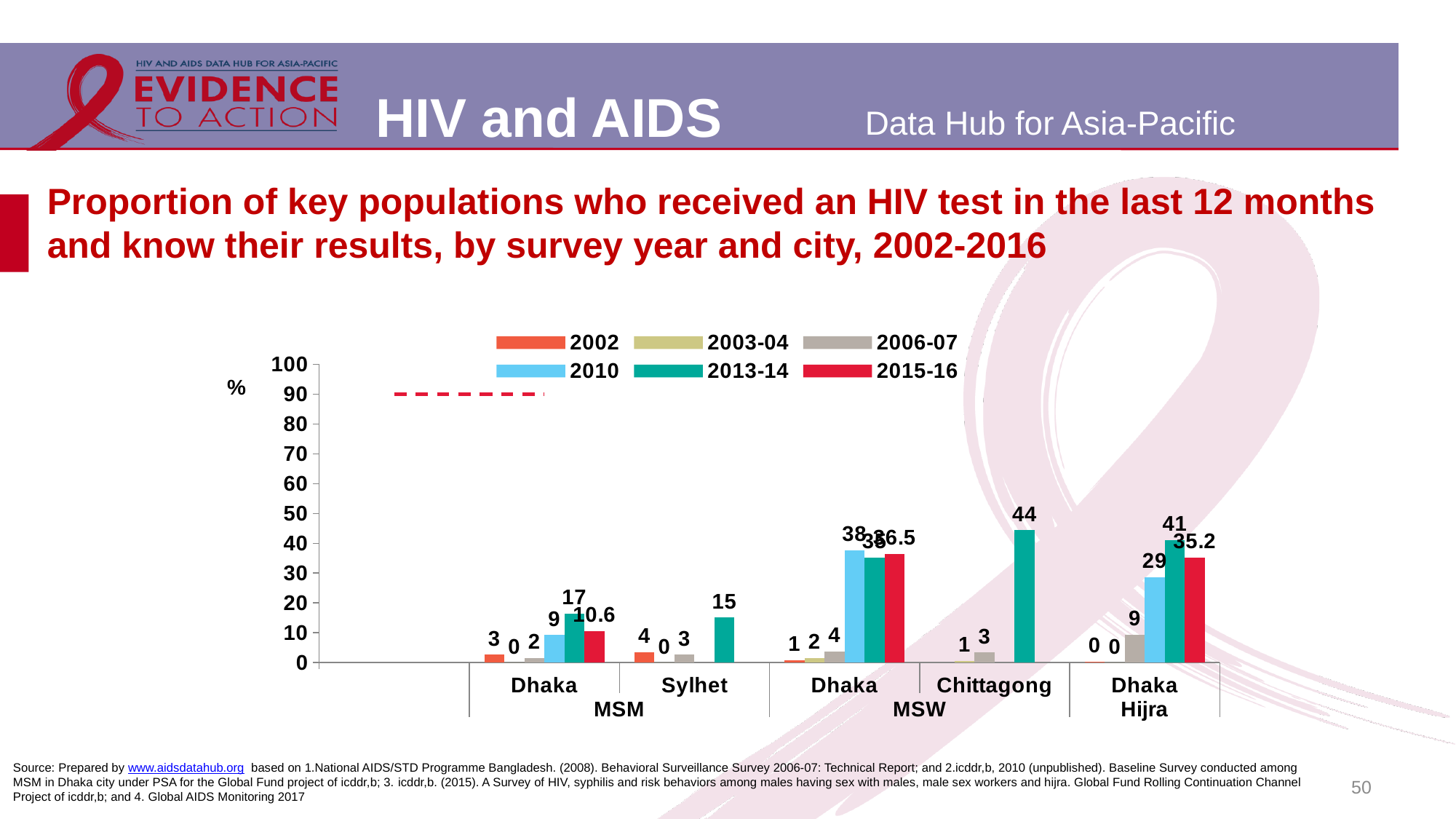
How many survey-year series does the legend list? 6 What is the value for MSM in Dhaka in 2013-14? 17 Which is larger in 2013-14: the value for MSM in Dhaka or MSM in Sylhet? MSM in Dhaka Which city and population group has the highest value on the chart? MSW in Chittagong (2013-14) What unit is shown on the y axis? % How many city groups are shown along the x axis? 5 What is the value for MSW in Chittagong in 2013-14? 44 What is the difference between the 2010 and 2015-16 values for MSW in Dhaka? 1.5 What is the difference between the 2013-14 and 2010 values for Hijra in Dhaka? 12 What is the value for MSM in Dhaka in 2015-16? 10.6 What is the value for Hijra in Dhaka in 2015-16? 35.2 What kind of chart is shown on the slide? bar chart